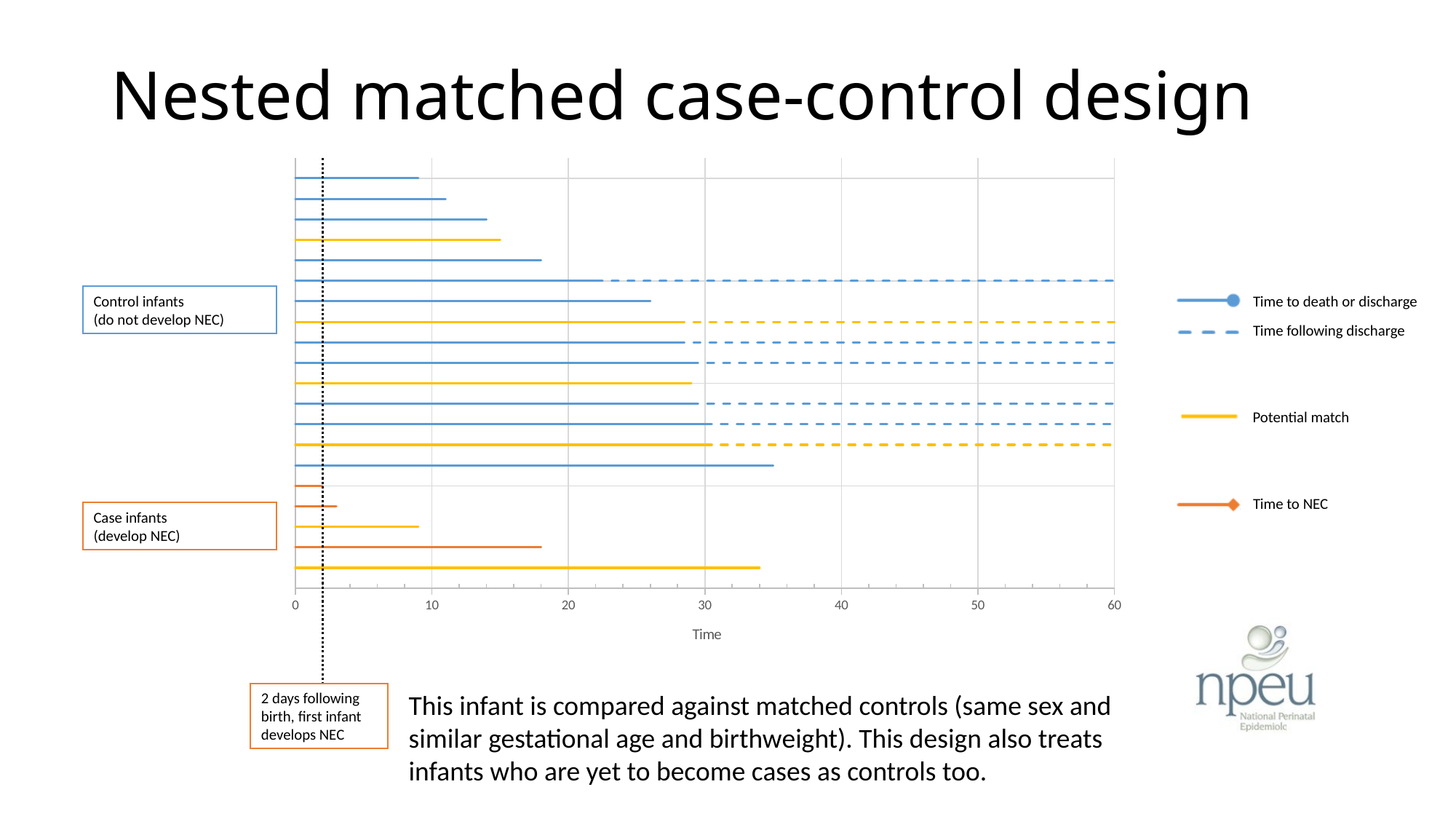
Which is longer: the longest 'Time to NEC' bar or the longest 'Potential match' bar among the case infants? Potential match Which legend entry is drawn with a dashed line? Time following discharge How many bars are shown for the control infants (do not develop NEC) group? 15 What kind of chart is shown on the slide? Line chart Is the shortest 'Time to NEC' bar among the case infants greater or less than 10 on the Time axis? less How many entries does the chart legend list? 4 Is the topmost bar in the chart greater or less than 10 on the Time axis? less Is the longest 'Potential match' bar among the case infants greater or less than 30 on the Time axis? greater What is the highest value shown on the x axis? 60 How many bars are shown for the case infants (develop NEC) group? 5 What is the title of the x axis? Time